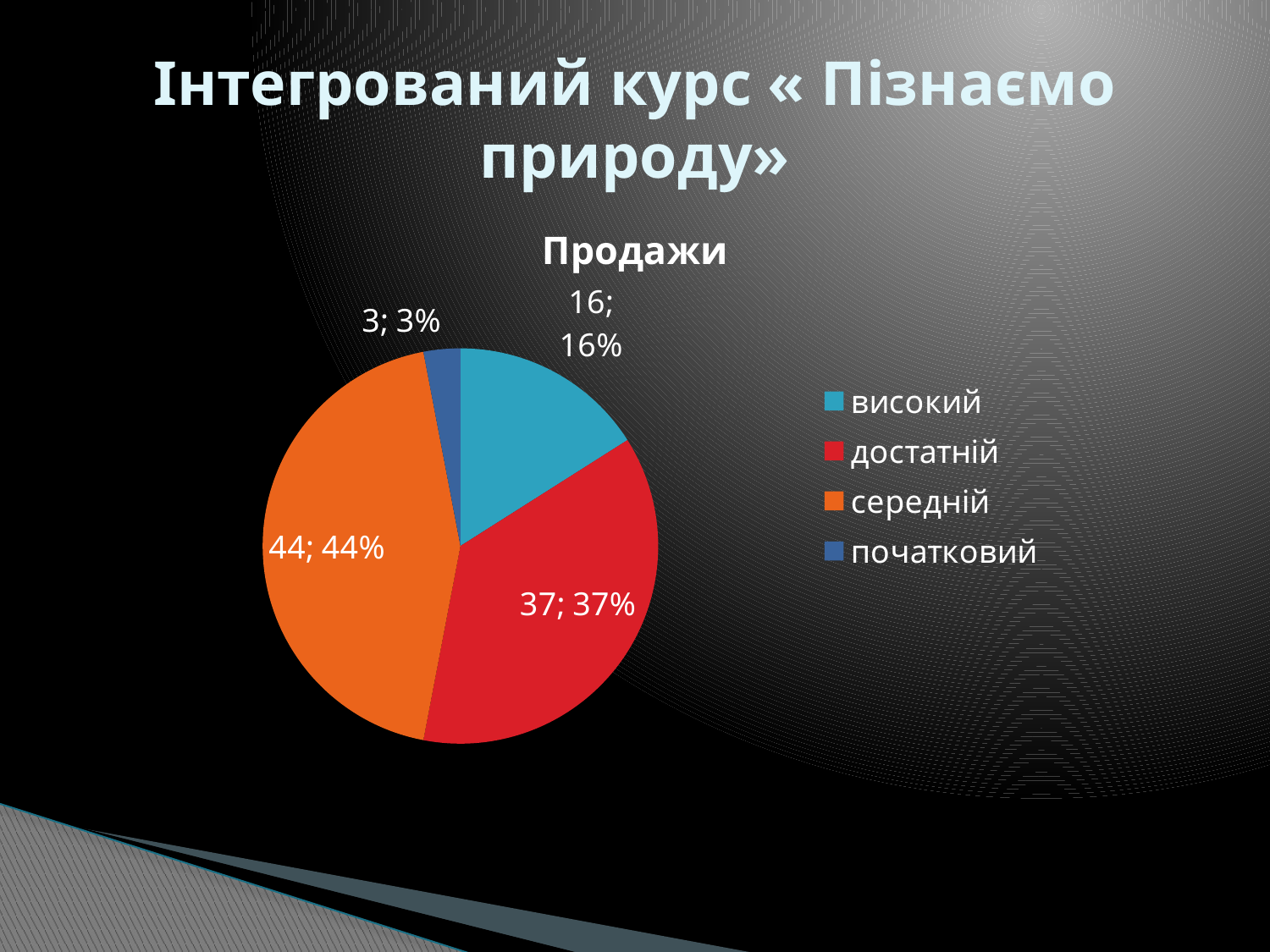
What is the value for середній? 44 What is the title of the chart? Продажи What is the value for початковий? 3 How many slices does the pie chart have? 4 What is the value for достатній? 37 What is the difference between the values for середній and високий? 28 How many entries does the legend list? 4 What kind of chart is shown on the slide? pie chart What share of the pie does достатній represent? 37% Which category has the largest slice? середній Which category has the smallest slice? початковий What is the value for високий? 16